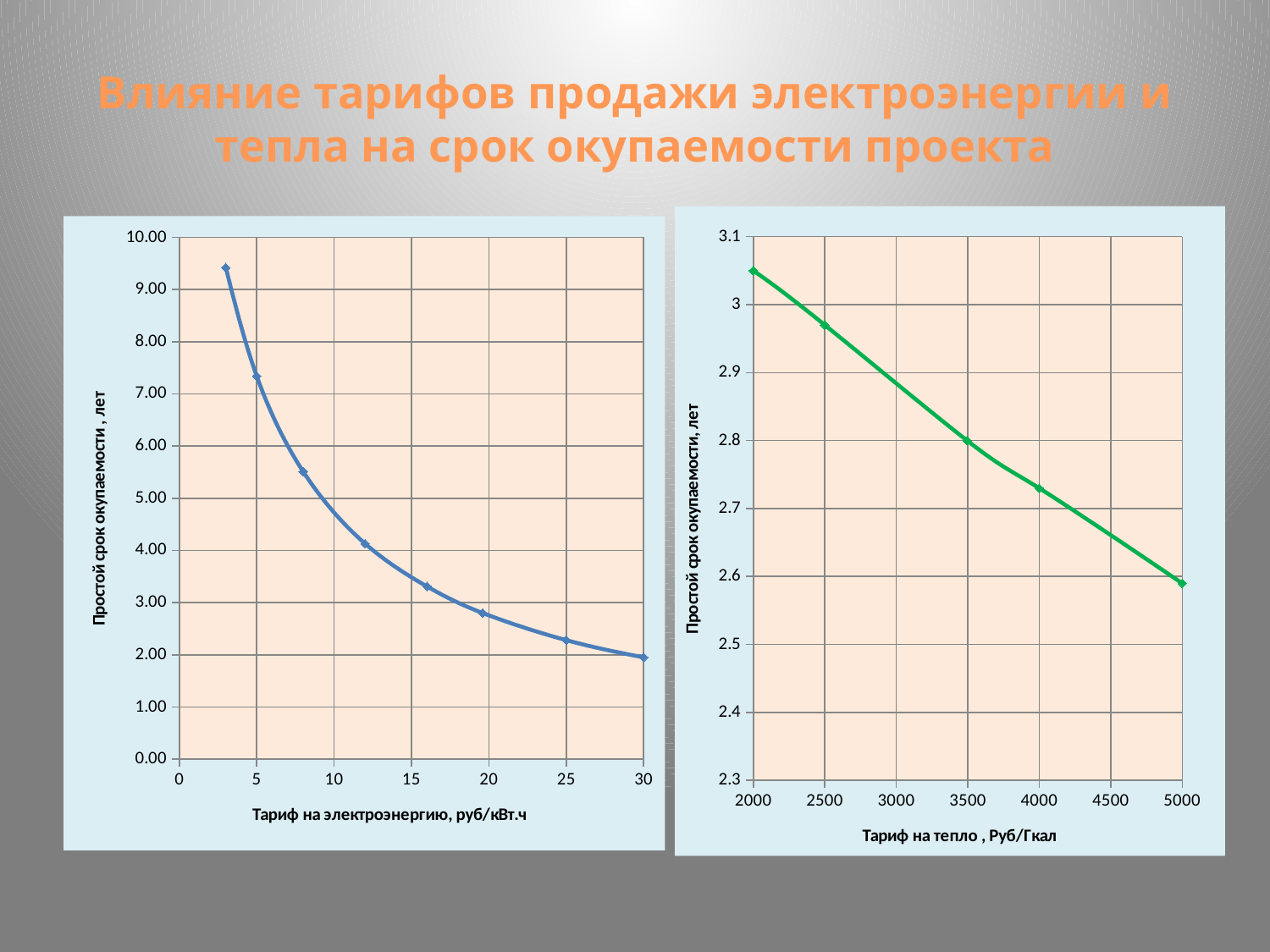
How many data points are plotted in the right chart? 5 What kind of chart is the right chart on the slide? Line chart What kind of chart is the left chart on the slide? Line chart What is the x-axis title of the right chart? Тариф на тепло , Руб/Гкал In the left chart, is the payback period at an electricity tariff of 16 руб/кВт.ч greater or less than 3.00 years? greater In the right chart, is the payback period at a heat tariff of 2500 Руб/Гкал greater or less than 3? less In the left chart, do the values rise or fall as the electricity tariff increases along the x axis? Fall In the left chart, which has the larger payback period: an electricity tariff of 5 or of 30 руб/кВт.ч? 5 In the right chart, is the payback period at a heat tariff of 2000 Руб/Гкал greater or less than 3? greater In the right chart, do the values rise or fall as the heat tariff increases along the x axis? Fall How many data points are plotted in the left chart? 8